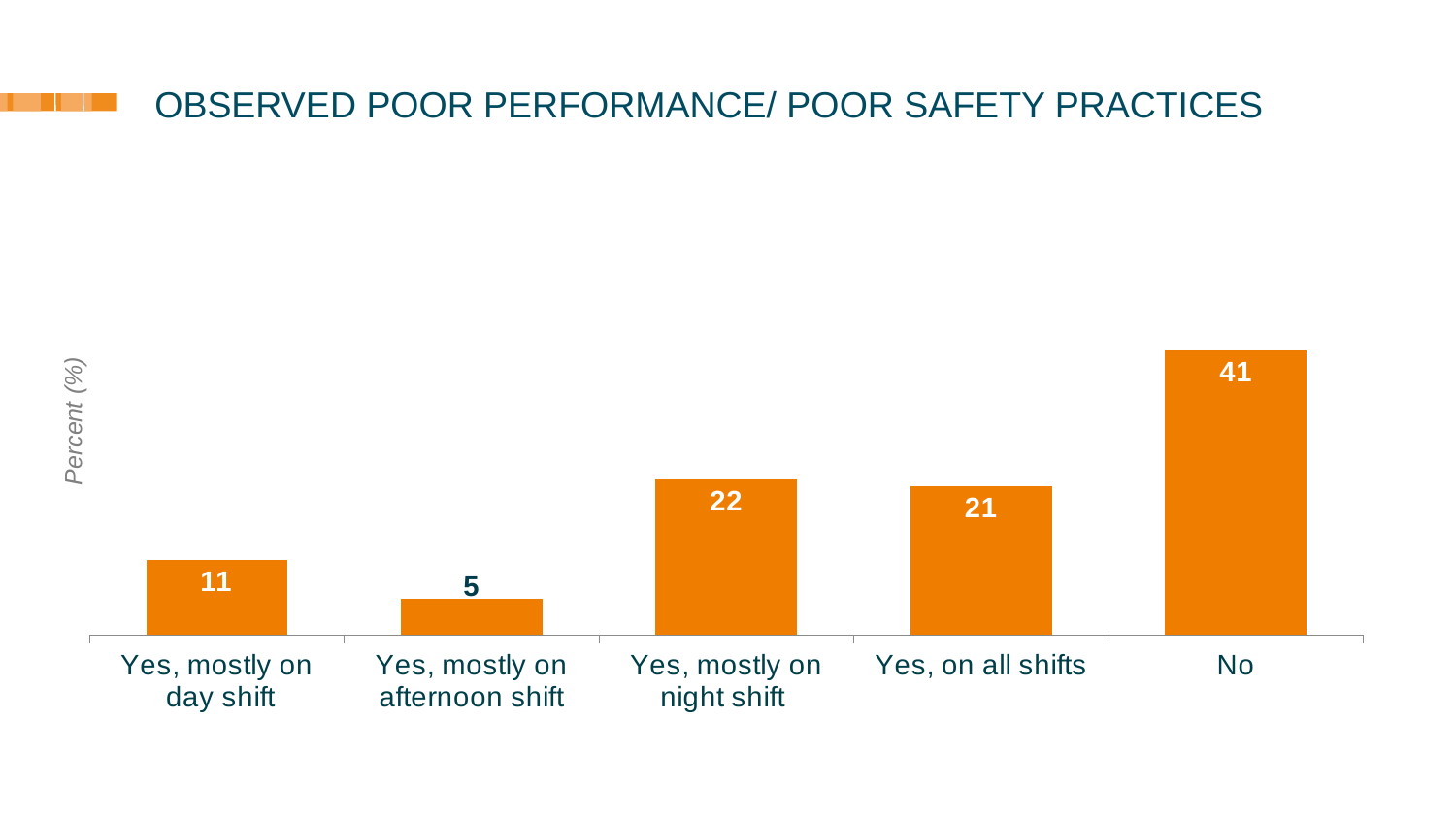
What is the difference between the values for "No" and "Yes, mostly on night shift"? 19 What is the value for "Yes, on all shifts"? 21 What is the value for "Yes, mostly on afternoon shift"? 5 Which category has the highest value? No What is the value for "Yes, mostly on night shift"? 22 Which is larger, the value for "Yes, mostly on day shift" or "Yes, mostly on afternoon shift"? Yes, mostly on day shift Which category has the lowest value? Yes, mostly on afternoon shift What is the value for "Yes, mostly on day shift"? 11 What is the value for "No"? 41 What kind of chart is shown on the slide? Bar chart How many categories are shown on the chart? 5 What is the label on the vertical axis? Percent (%)